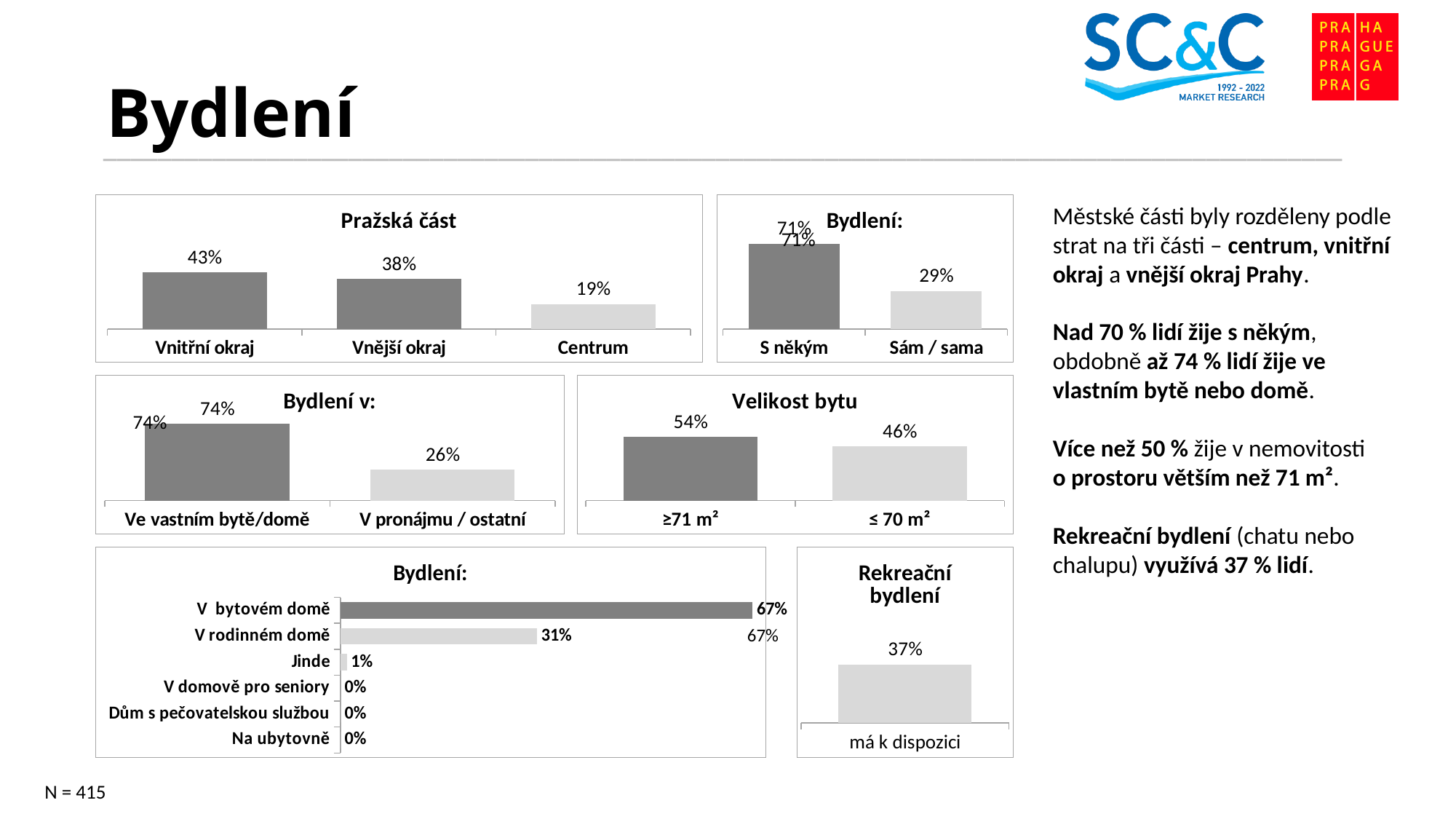
In the 'Rekreační bydlení' chart, what is the value for má k dispozici? 37% In the bottom-left 'Bydlení:' chart, what is the value for V rodinném domě? 31% In the 'Velikost bytu' chart, what is the difference between ≥71 m² and ≤ 70 m²? 8% In the bottom-left 'Bydlení:' chart, which category has the highest value? V bytovém domě In the top-right 'Bydlení:' chart, which is larger, S někým or Sám / sama? S někým In the 'Pražská část' chart, what is the value for Vnitřní okraj? 43% In the 'Pražská část' chart, which category has the lowest value? Centrum In the 'Velikost bytu' chart, what is the value for ≥71 m²? 54% In the top-right 'Bydlení:' chart, what is the value for Sám / sama? 29% In the bottom-left 'Bydlení:' chart, how many categories are shown? 6 In the 'Bydlení v:' chart, what is the value for V pronájmu / ostatní? 26% In the 'Pražská část' chart, what is the difference between Vnitřní okraj and Centrum? 24%